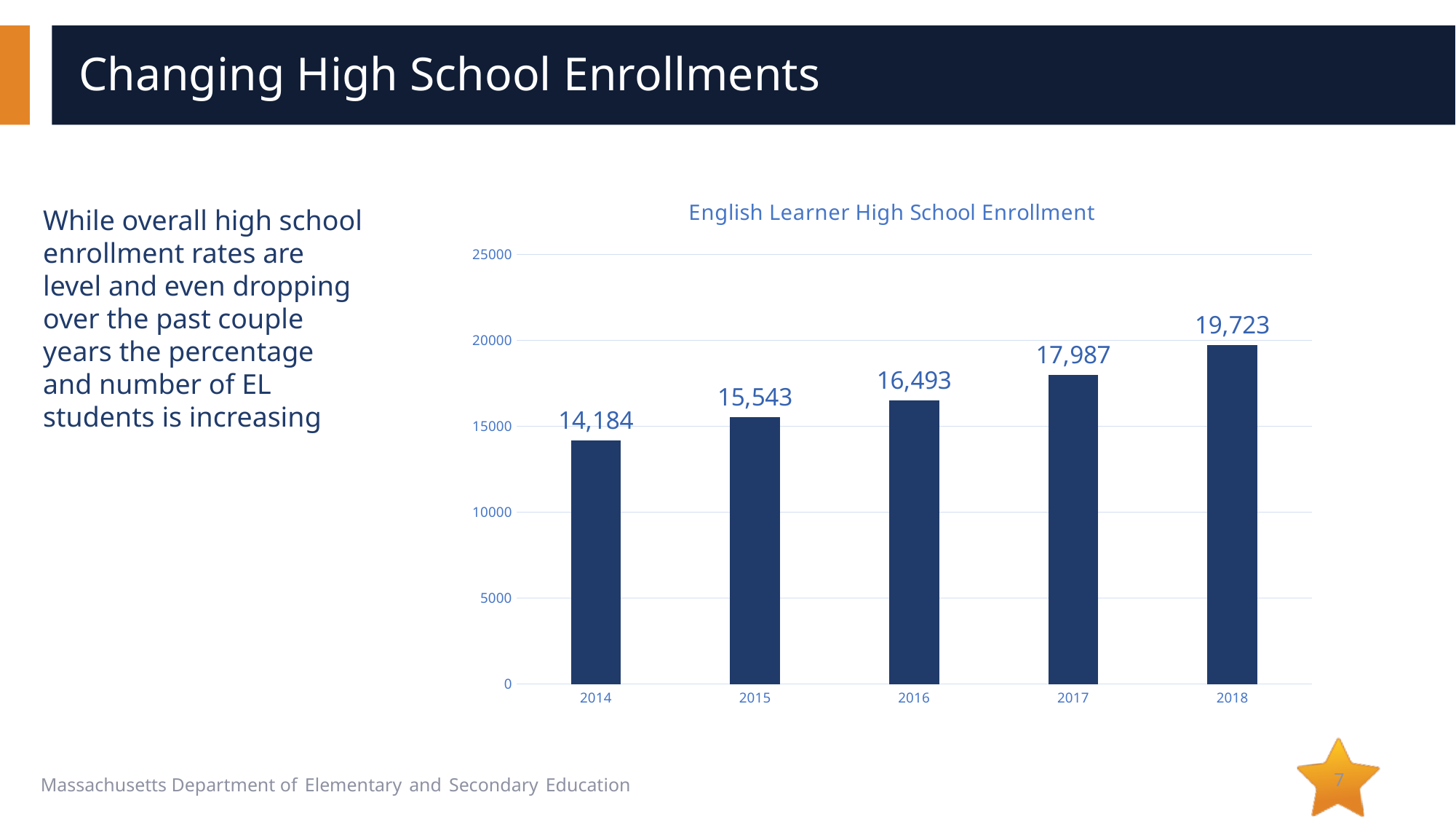
What is the difference in English Learner high school enrollment between 2017 and 2016? 1,494 Which year has the highest English Learner high school enrollment? 2018 What kind of chart is used to show English Learner high school enrollment? Bar chart How many years are shown on the chart? 5 Is the English Learner high school enrollment for 2018 greater or less than 20000? less Does English Learner high school enrollment rise or fall from 2014 to 2018? Rise What is the English Learner high school enrollment for 2018? 19,723 What is the difference in English Learner high school enrollment between 2018 and 2014? 5,539 What is the English Learner high school enrollment for 2014? 14,184 Which year has the lowest English Learner high school enrollment? 2014 What is the English Learner high school enrollment for 2016? 16,493 Which year has a larger English Learner high school enrollment, 2015 or 2017? 2017